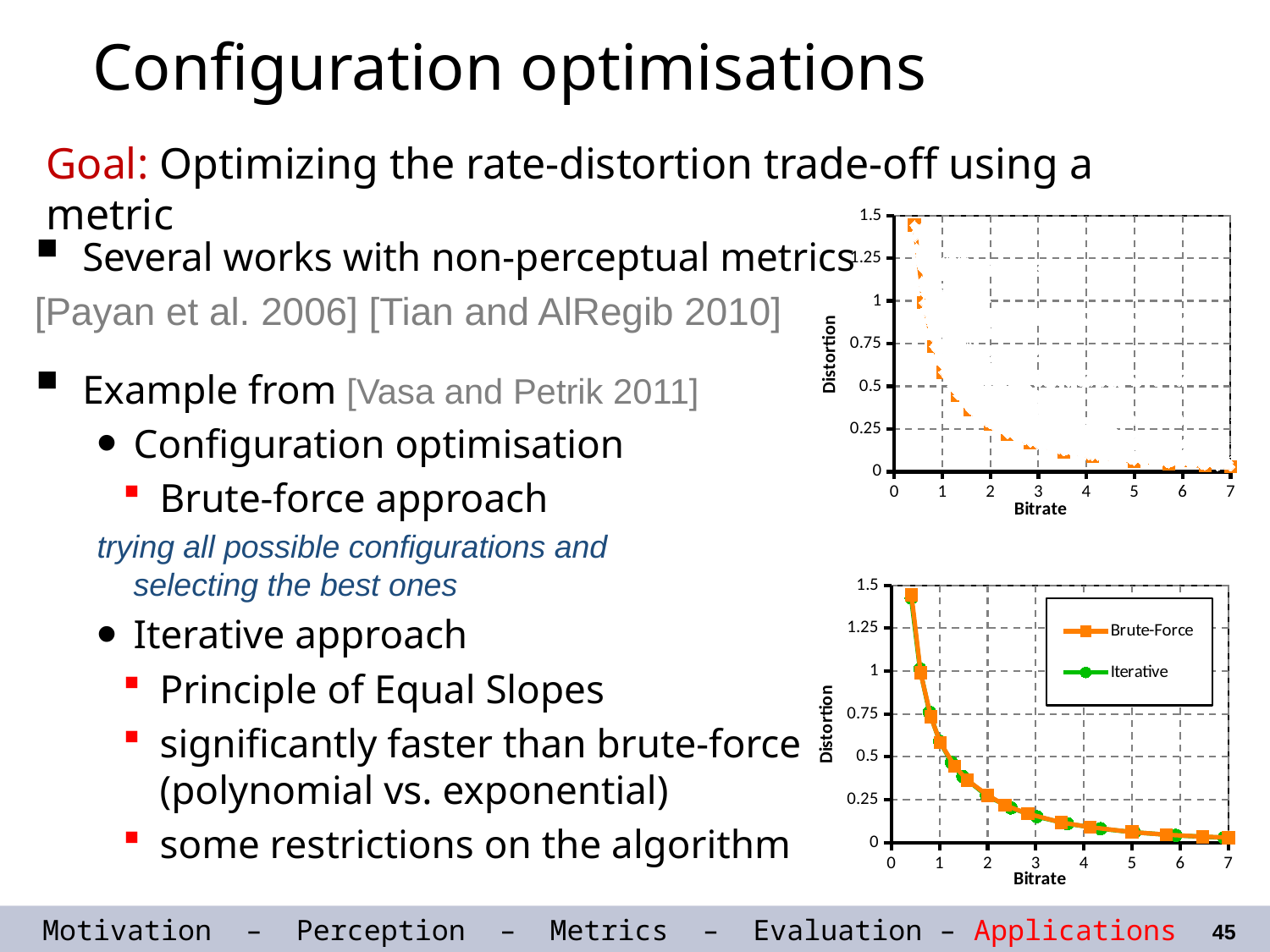
What is the label of the x axis on the bottom chart? Bitrate In the bottom chart, does Distortion rise or fall as Bitrate increases? fall What kind of chart is the bottom chart on the slide? line chart In the bottom chart, is the Distortion value at Bitrate 5 greater or less than 0.25? less In the bottom chart, which colour is used for the Brute-Force series? orange What are the two series named in the legend of the bottom chart? Brute-Force and Iterative In the top chart, is the Distortion value at Bitrate 3 greater or less than 0.5? less In the top chart, does Distortion rise or fall as Bitrate increases? fall How many series does the legend of the bottom chart list? 2 In the bottom chart, is the Distortion value at Bitrate 0.5 greater or less than 1? greater